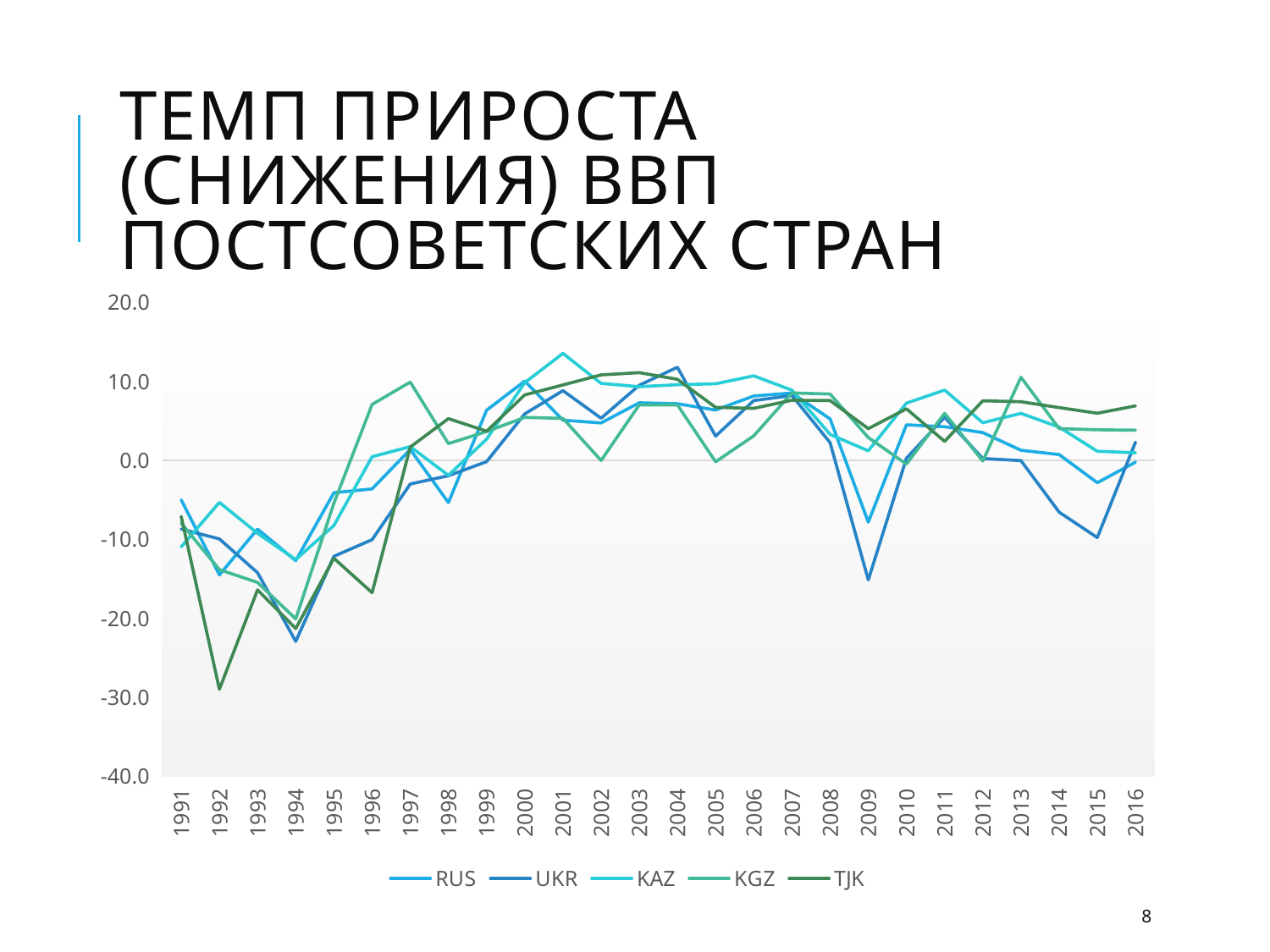
What is the title of the chart? ТЕМП ПРИРОСТА (СНИЖЕНИЯ) ВВП ПОСТСОВЕТСКИХ СТРАН What kind of chart is shown on the slide? line chart Does the UKR line rise or fall from 1994 to 2000? rise Which series has the highest value in 2001? KAZ Is the value for KAZ in 2001 greater or less than 10? greater How many years are shown on the x axis? 26 Is the value for TJK in 1992 greater or less than -20? less Which series has the lowest value in 2009? UKR Is the value for UKR in 2009 greater or less than -10? less Which is lower in 2015, RUS or UKR? UKR How many series does the legend list? 5 Which series has the lowest value in 1992? TJK